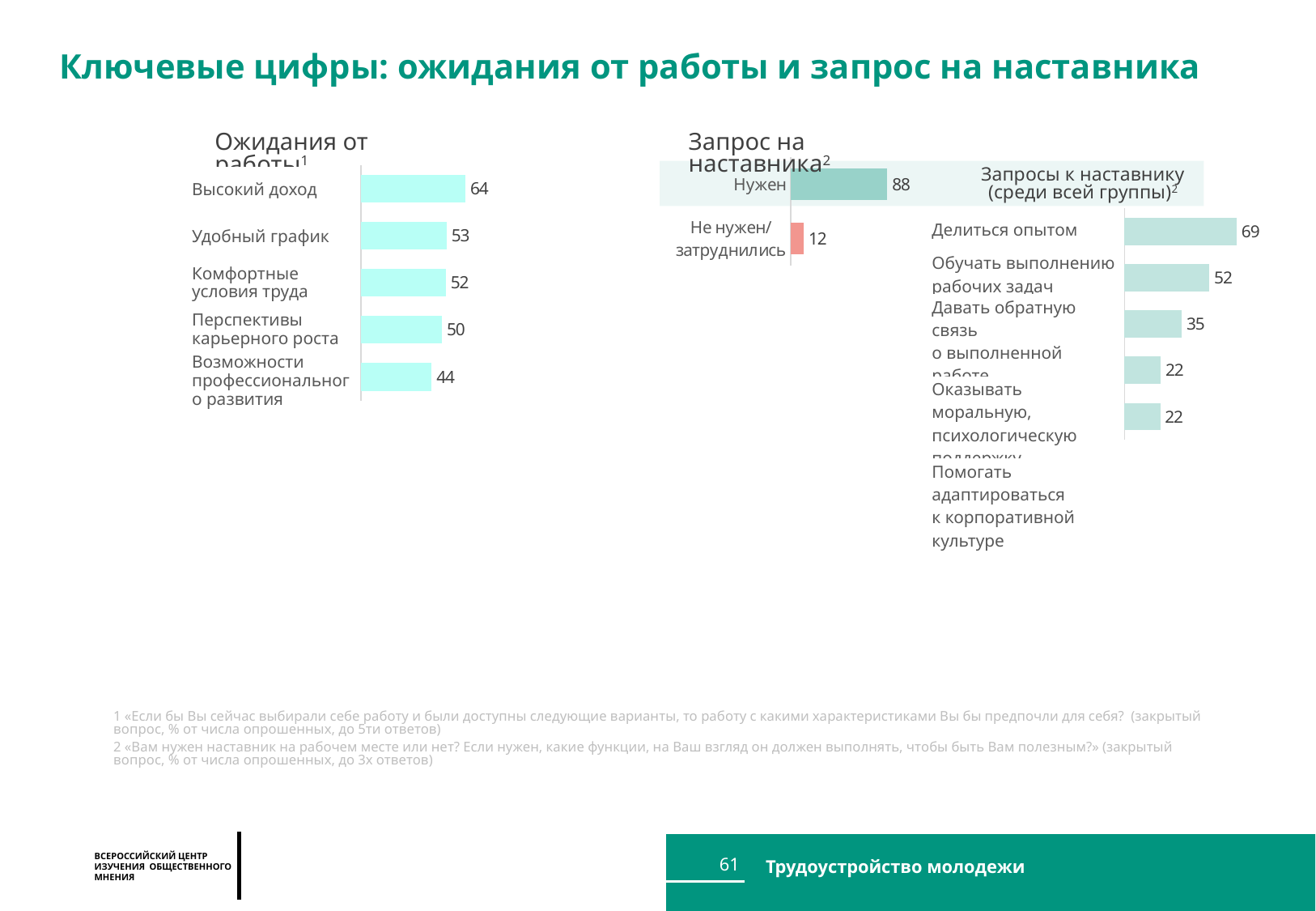
On the chart 'Запрос на наставника', what is the value for 'Не нужен/затруднились'? 12 On the chart 'Запрос на наставника', what is the value for 'Нужен'? 88 On the chart 'Ожидания от работы', what is the value for 'Перспективы карьерного роста'? 50 On the chart 'Ожидания от работы', which category has the lowest value? Возможности профессионального развития On the chart 'Запросы к наставнику (среди всей группы)', which category has the highest value? Делиться опытом On the chart 'Запросы к наставнику (среди всей группы)', what is the value for 'Делиться опытом'? 69 On the chart 'Запрос на наставника', which is larger: 'Нужен' or 'Не нужен/затруднились'? Нужен On the chart 'Запросы к наставнику (среди всей группы)', what is the difference between 'Делиться опытом' and 'Обучать выполнению рабочих задач'? 17 What kind of chart is 'Ожидания от работы'? Bar chart On the chart 'Ожидания от работы', how many categories are shown? 5 On the chart 'Ожидания от работы', what is the difference between 'Высокий доход' and 'Удобный график'? 11 On the chart 'Ожидания от работы', what is the value for 'Высокий доход'? 64